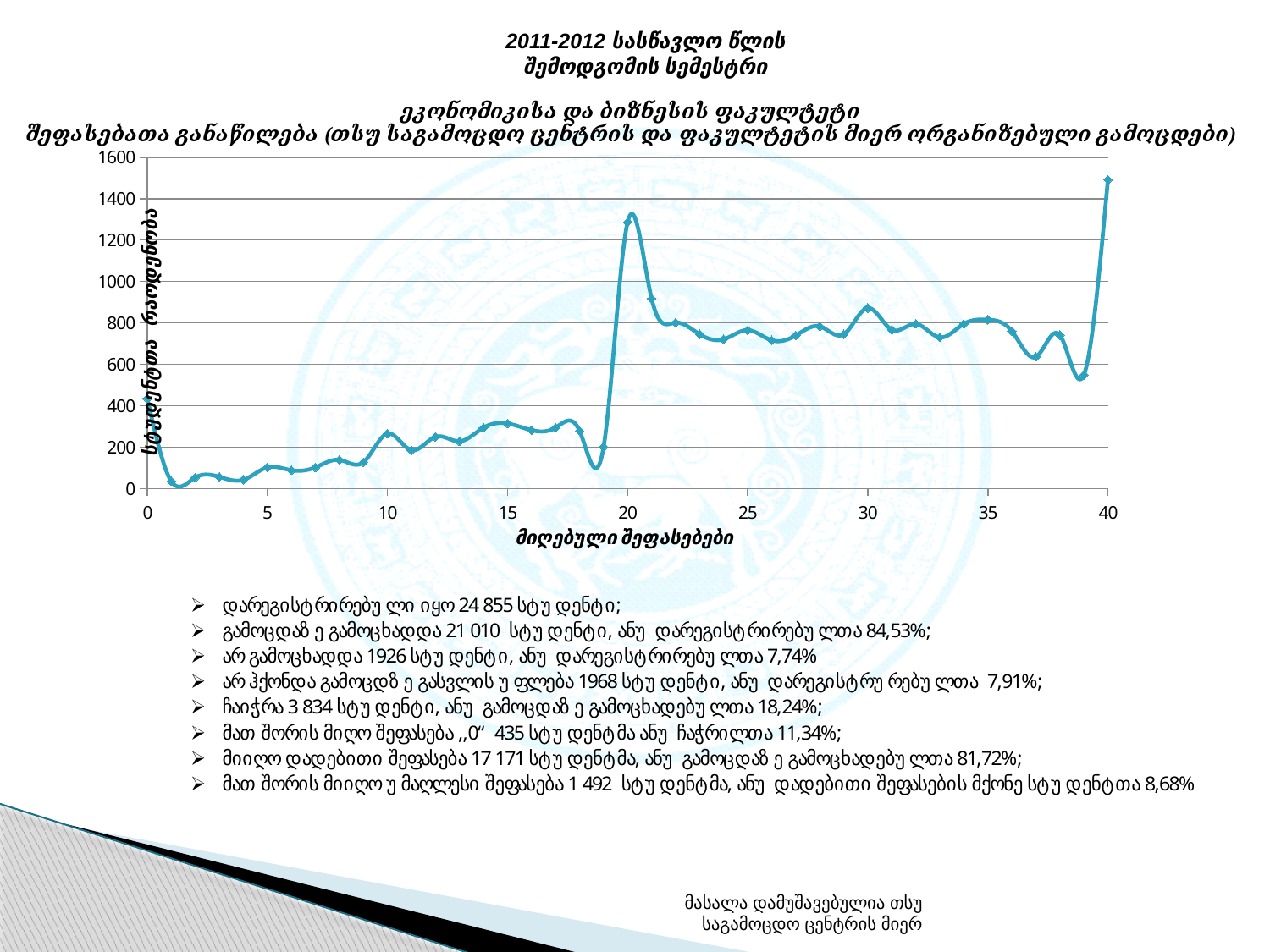
Is the value for score 25 greater or less than 1000? less Do the values rise or fall from score 20 to score 21? fall What is the label of the x axis? მიღებული შეფასებები Which has the larger value, score 20 or score 10? score 20 Is the value for score 20 greater or less than 1000? greater Which has the larger value, score 39 or score 40? score 40 Is the value for score 10 greater or less than 400? less What is the highest tick value shown on the y axis? 1600 What kind of chart is shown on the slide? line chart